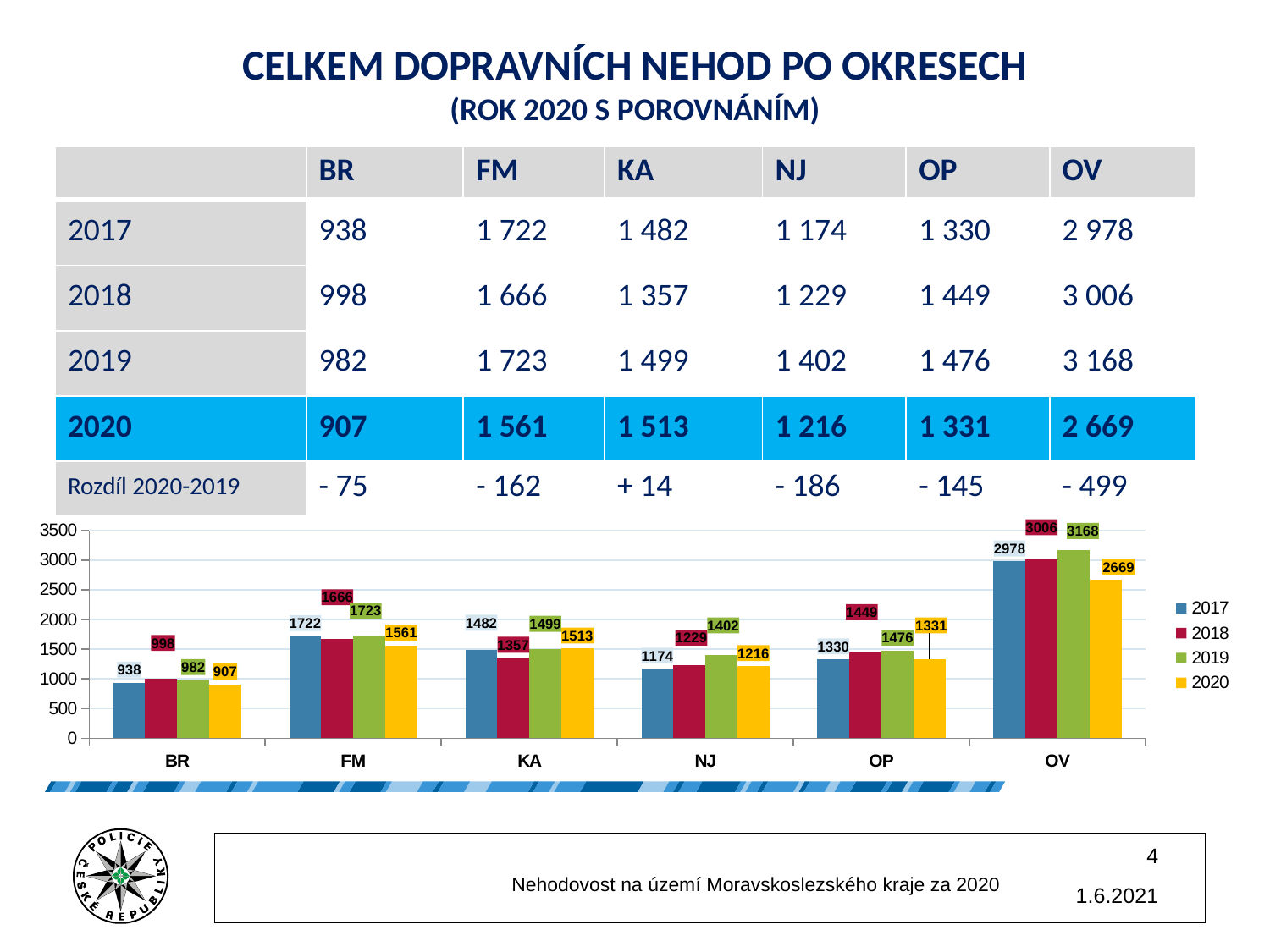
What is the value for KA in 2018 in the chart? 1357 Which district has the lowest value in 2020 in the chart? BR Is the 2018 value for OP in the chart greater or less than 1500? less What is the value for OV in 2020 in the chart? 2669 How many series does the chart legend list? 4 Which colour represents the 2020 series in the chart? yellow What is the difference between the 2019 and 2020 values for OV in the chart? 499 What type of chart is shown on the slide? bar chart Which district has the highest value in 2019 in the chart? OV Which is larger in the chart: the 2017 value for FM or the 2017 value for KA? FM How many district categories are shown on the x axis of the chart? 6 What is the value for NJ in 2019 in the chart? 1402